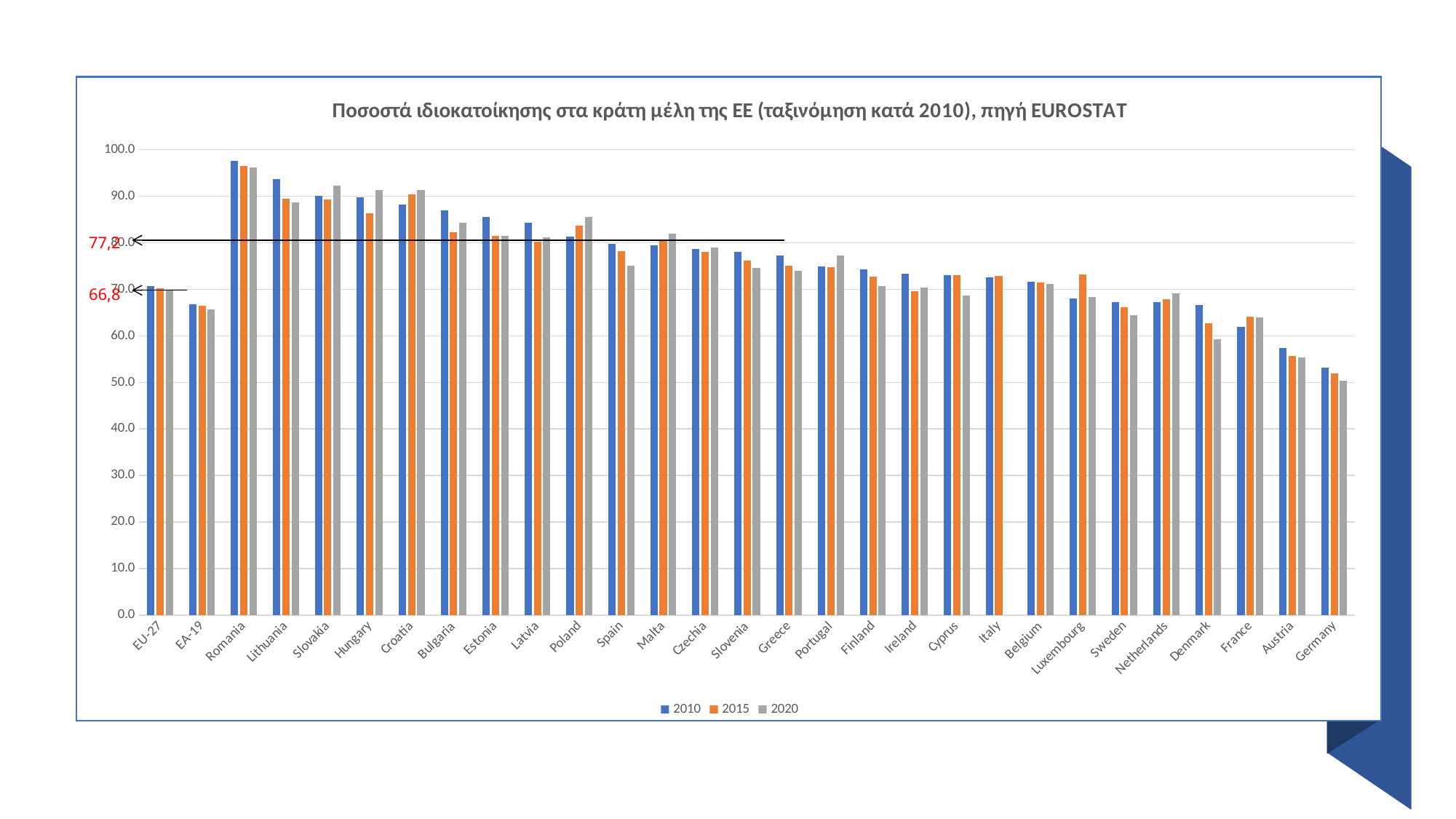
Is the value for Austria in 2015 greater or less than 60.0? less Which category has the highest value for 2010? Romania Is the value for Romania in 2010 greater or less than 90.0? greater Which category has the lowest value for 2010? Germany Is the value for Germany in 2020 greater or less than 60.0? less How many categories are shown along the x axis? 29 Which source is named in the chart title? EUROSTAT Which series is shown in orange in the legend? 2015 Which is larger, the 2010 value for Lithuania or the 2010 value for Germany? Lithuania Do the 2010 values generally rise or fall moving from left to right along the x axis? fall How many series does the legend list? 3 What kind of chart is shown on the slide? bar chart